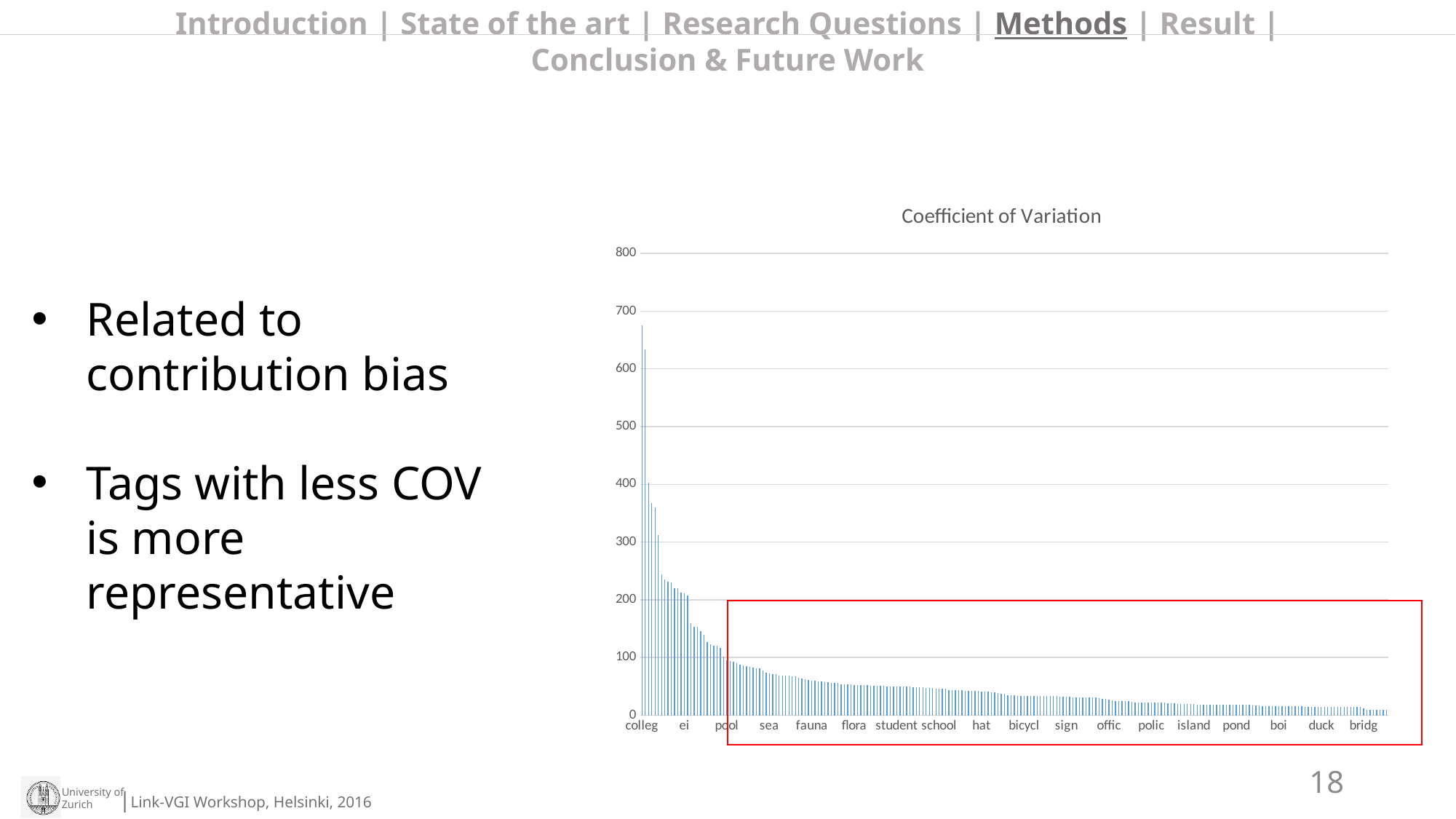
Is the value for sea greater or less than 100? less Is the value for ei greater or less than 300? less Do the values rise or fall from left to right along the x axis? fall Which is larger, the value for colleg or the value for hat? colleg Is the value for bridg greater or less than 100? less Which category has the highest coefficient of variation? colleg What is the title of the chart? Coefficient of Variation What kind of chart is shown on the slide? bar chart How many category labels are printed along the x axis? 18 What is the highest value shown on the y axis? 800